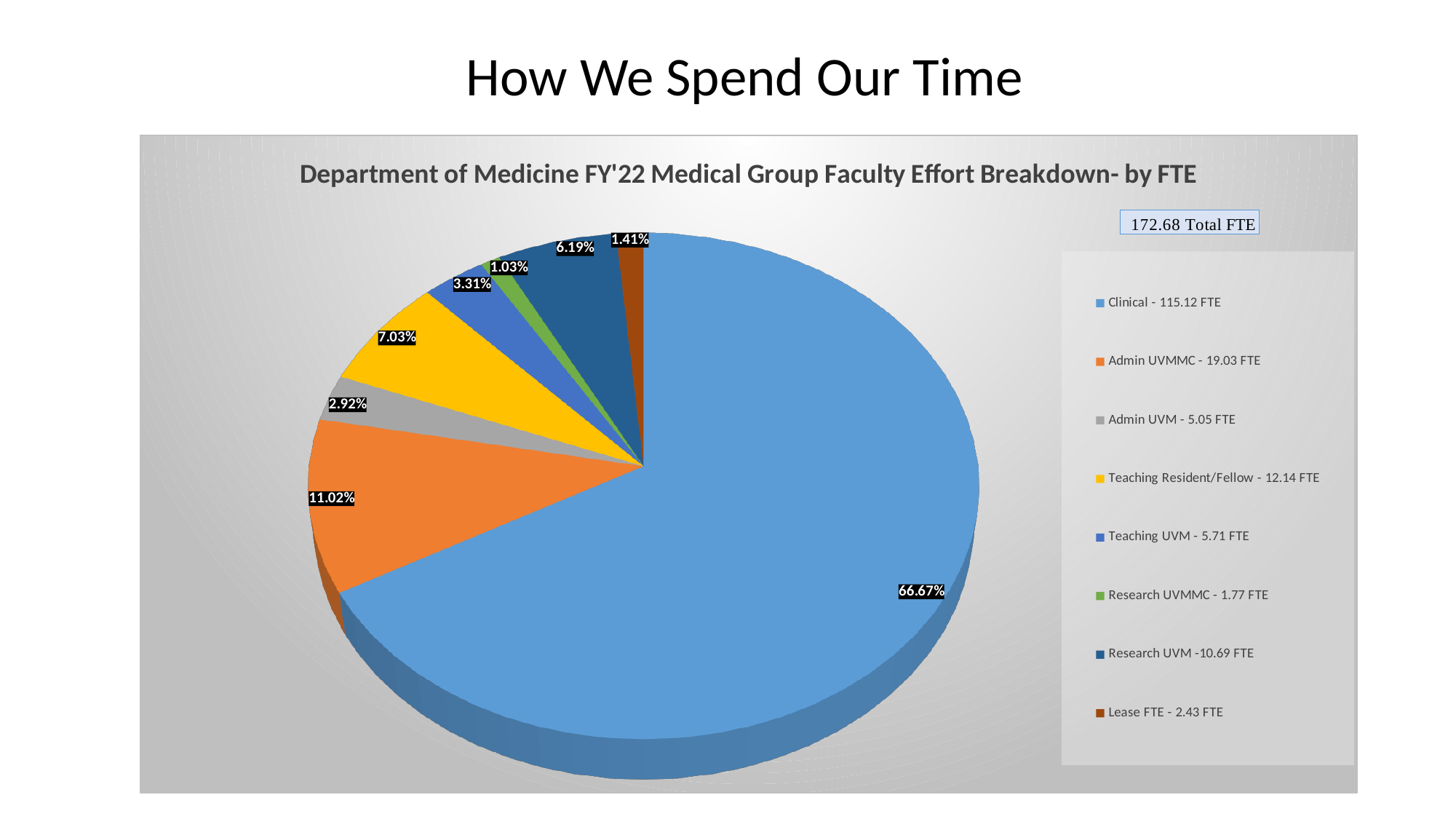
What kind of chart is shown on the slide? Pie chart Which slice is larger, Teaching UVM or Lease FTE? Teaching UVM How many FTE does the legend list for Admin UVM? 5.05 FTE Which category has the smallest share of the pie? Research UVMMC How many FTE does the legend list for Research UVMMC? 1.77 FTE What percentage of the pie does the Teaching Resident/Fellow slice represent? 7.03% What percentage of the pie does the Admin UVMMC slice represent? 11.02% Which category has the largest share of the pie? Clinical What percentage of the pie does the Clinical slice represent? 66.67% What is the difference in percentage points between the Admin UVMMC slice and the Teaching Resident/Fellow slice? 3.99 How many categories does the legend list? 8